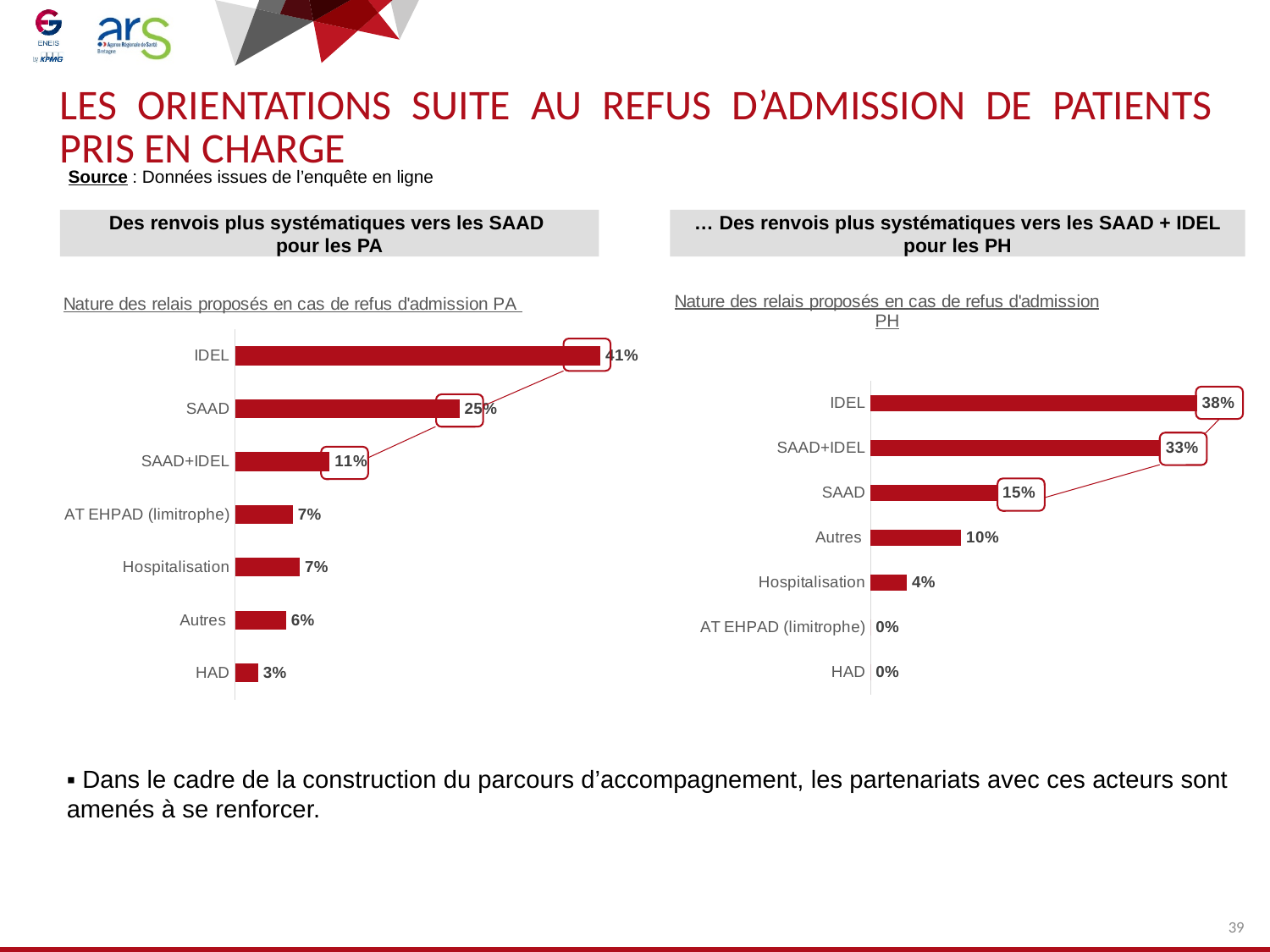
In the right chart (refus d'admission PH), what is the value for Hospitalisation? 4% In the right chart (refus d'admission PH), which category has the highest value? IDEL In the left chart (Nature des relais proposés en cas de refus d'admission PA), what is the value for SAAD? 25% What type of chart is used on the right side of the slide (refus d'admission PH)? Bar chart In the right chart (refus d'admission PH), what is the difference between IDEL and SAAD? 23% In the left chart (refus d'admission PA), what is the difference between SAAD and SAAD+IDEL? 14% In the right chart (refus d'admission PH), which is larger, Autres or Hospitalisation? Autres In the right chart (Nature des relais proposés en cas de refus d'admission PH), what is the value for SAAD+IDEL? 33% In the left chart (refus d'admission PA), what is the value for HAD? 3% In the left chart (refus d'admission PA), how many categories are shown? 7 In the left chart (refus d'admission PA), which category has the lowest value? HAD In the left chart (refus d'admission PA), which category has the highest value? IDEL